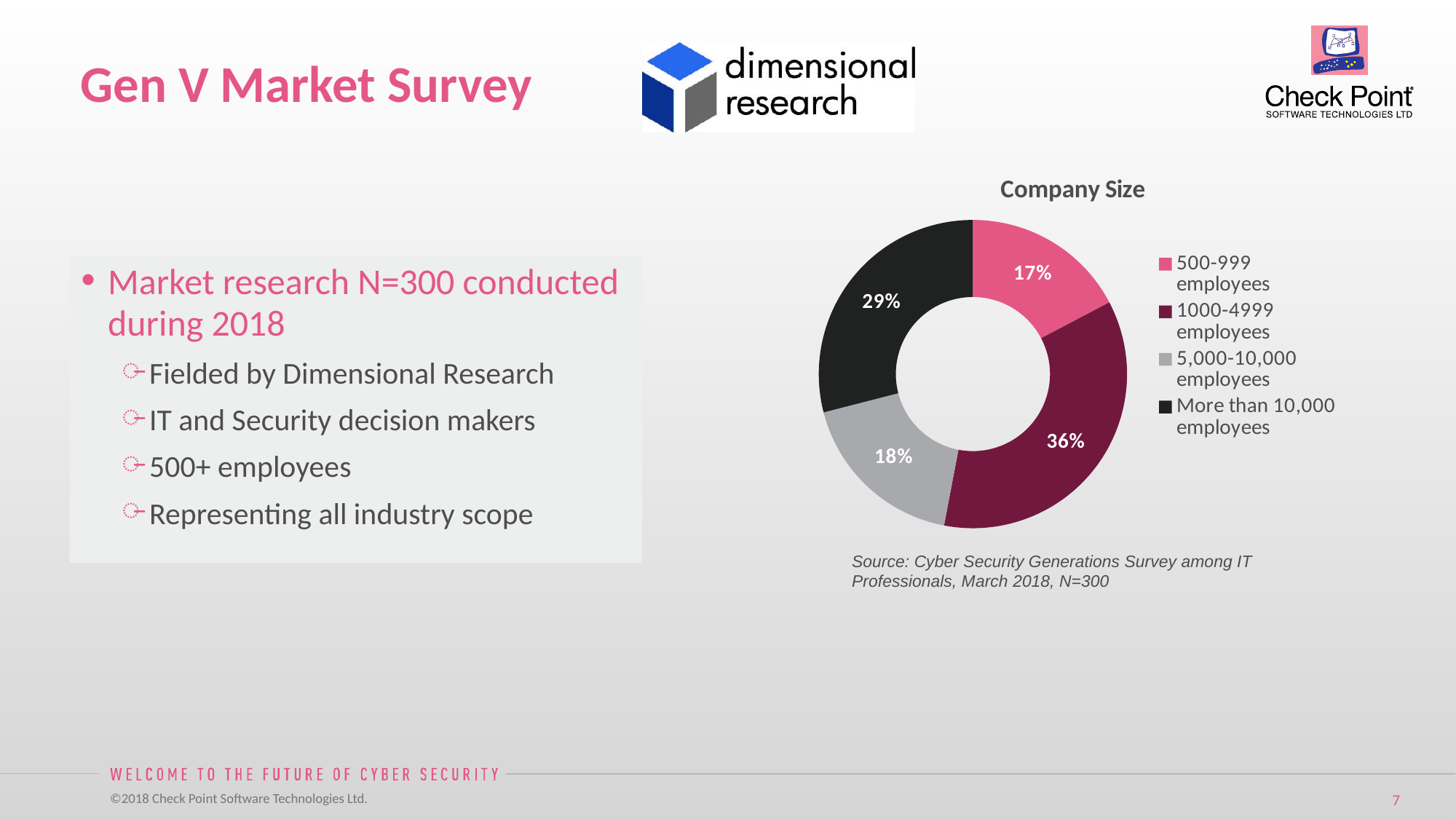
Which is larger in the Company Size chart: the share for 5,000-10,000 employees or the share for more than 10,000 employees? More than 10,000 employees What is the difference in percentage points between the 1000-4999 employees share and the more than 10,000 employees share? 7 What share of the Company Size chart is for companies with more than 10,000 employees? 29% Which company size category has the smallest share in the Company Size chart? 500-999 employees What share of the Company Size chart is for companies with 1000-4999 employees? 36% Which company size category has the largest share in the Company Size chart? 1000-4999 employees What is the title of the chart on the slide? Company Size What colour is the slice for more than 10,000 employees in the Company Size chart? Black What share of the Company Size chart is for companies with 5,000-10,000 employees? 18% What share of the Company Size chart is for companies with 500-999 employees? 17% How many company size categories are shown in the Company Size chart? 4 What kind of chart is the Company Size chart? Pie chart (doughnut)